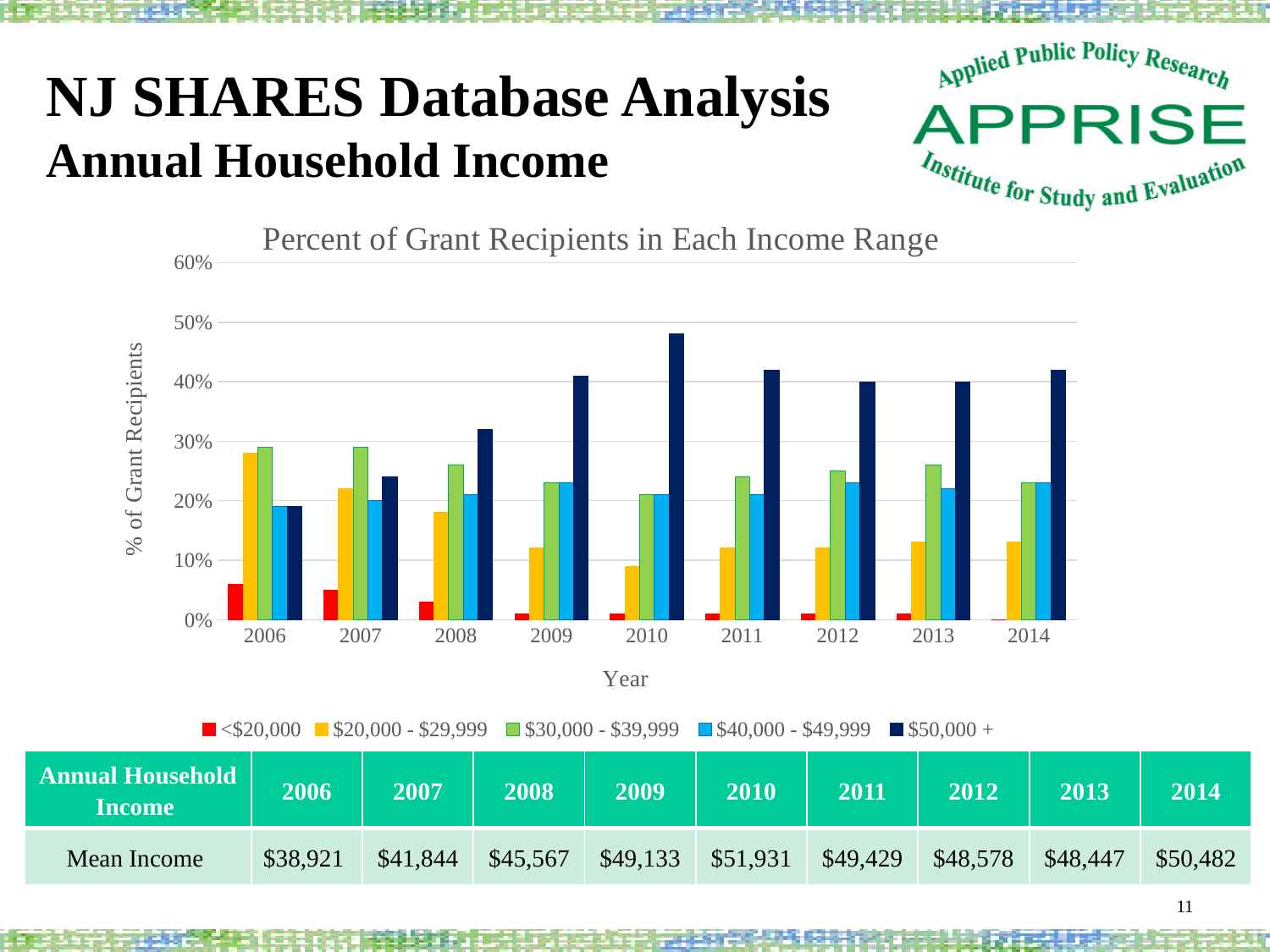
Which income range has the shortest bar in 2006? <$20,000 In which year is the $50,000 + bar the tallest? 2010 How many series does the chart legend list? 5 What is the title of the chart? Percent of Grant Recipients in Each Income Range How many years are shown along the x axis of the chart? 9 What kind of chart is shown on the slide? Bar chart Is the value for <$20,000 in 2014 greater or less than 10%? less Does the <$20,000 series rise or fall from 2006 to 2014? Fall Is the value for $50,000 + in 2010 greater or less than 40%? greater Which is larger: the $50,000 + value in 2006 or in 2010? 2010 Is the value for $20,000 - $29,999 in 2006 greater or less than 20%? greater Which income range is represented by the dark blue bars in the legend? $50,000 +